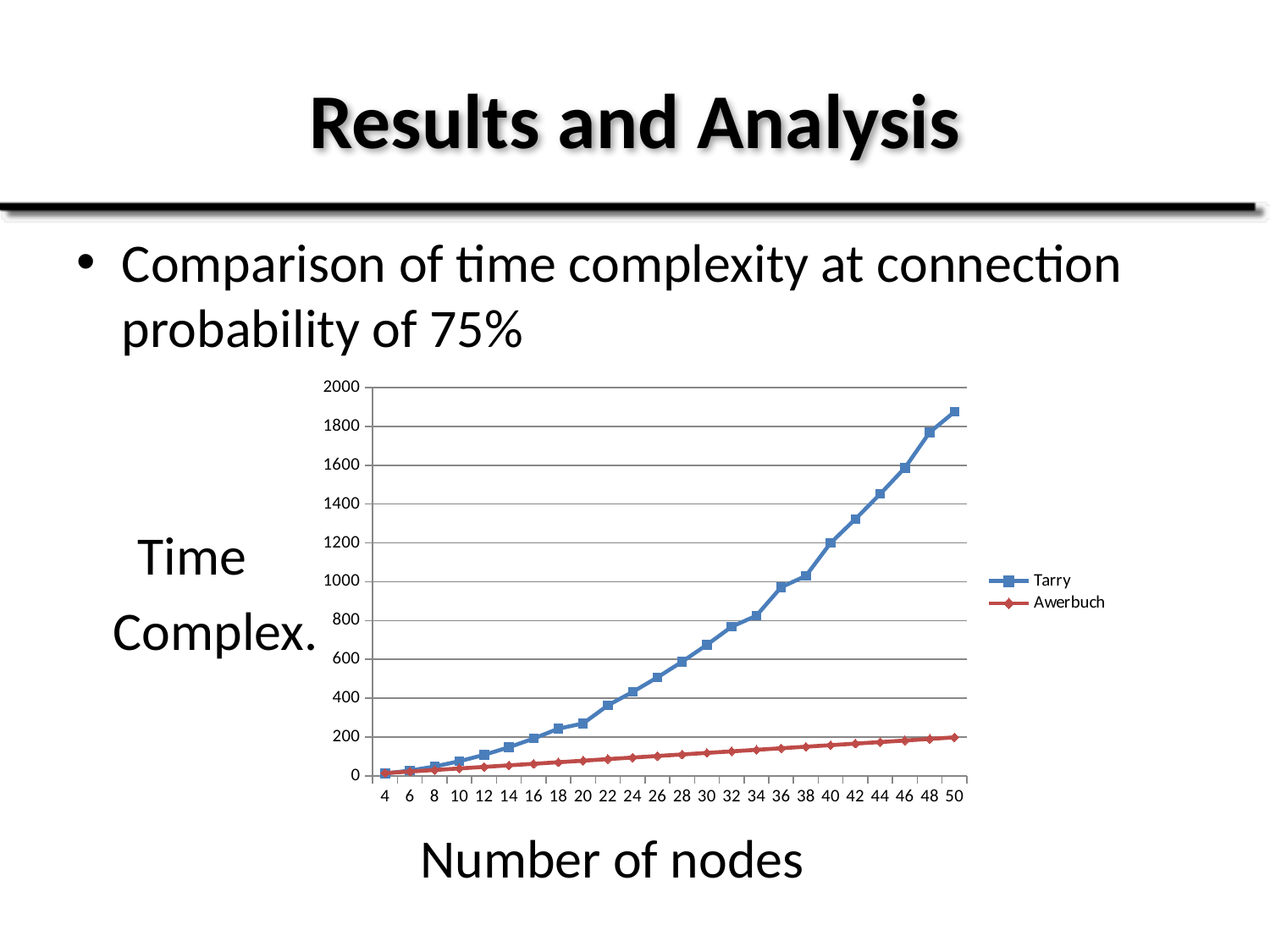
At 50 nodes, which series has the larger time complexity, Tarry or Awerbuch? Tarry Is the value for Tarry at 30 nodes greater or less than 600? greater At which number of nodes does the Tarry series reach its highest value? 50 Which two series are listed in the legend? Tarry and Awerbuch How many series does the legend list? 2 What kind of chart is shown on the slide? line chart Does the Awerbuch series rise or fall as the number of nodes increases? rise Is the value for Awerbuch at 30 nodes greater or less than 200? less Is the value for Tarry at 50 nodes greater or less than 1800? greater How many data points are plotted along the x axis for each series? 24 Does the Tarry series rise or fall as the number of nodes increases? rise What is the label of the x axis? Number of nodes